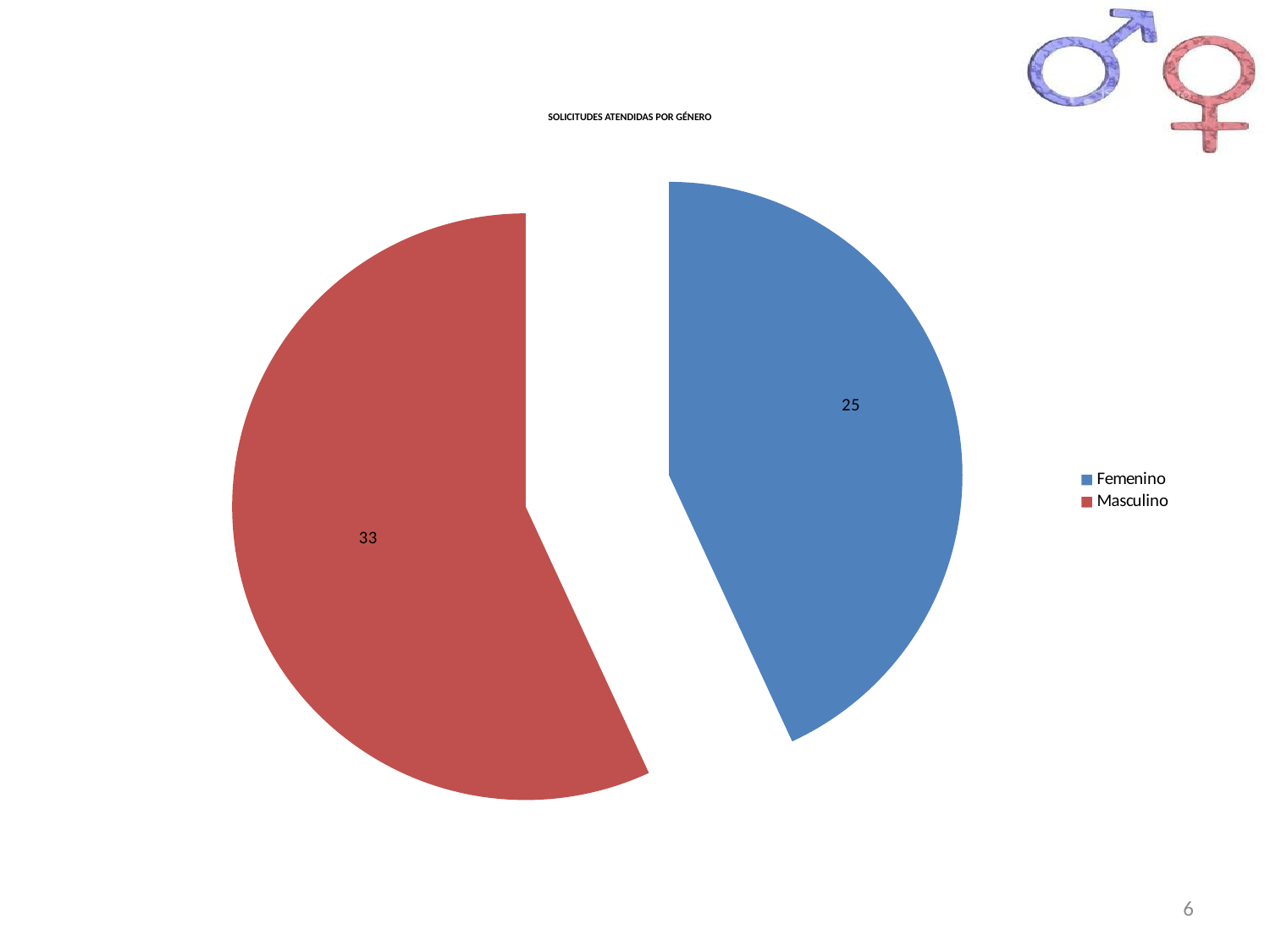
Which colour represents Femenino in the chart? blue What is the difference between the values for Masculino and Femenino? 8 How many entries does the legend list? 2 What kind of chart is shown on the slide? pie chart What is the value for Femenino? 25 What is the value for Masculino? 33 Which category has the largest slice? Masculino What is the title of the chart? SOLICITUDES ATENDIDAS POR GÉNERO Which category has the smallest slice? Femenino Which is larger, the value for Femenino or the value for Masculino? Masculino What is the total of the two slices? 58 How many categories does the pie chart have? 2